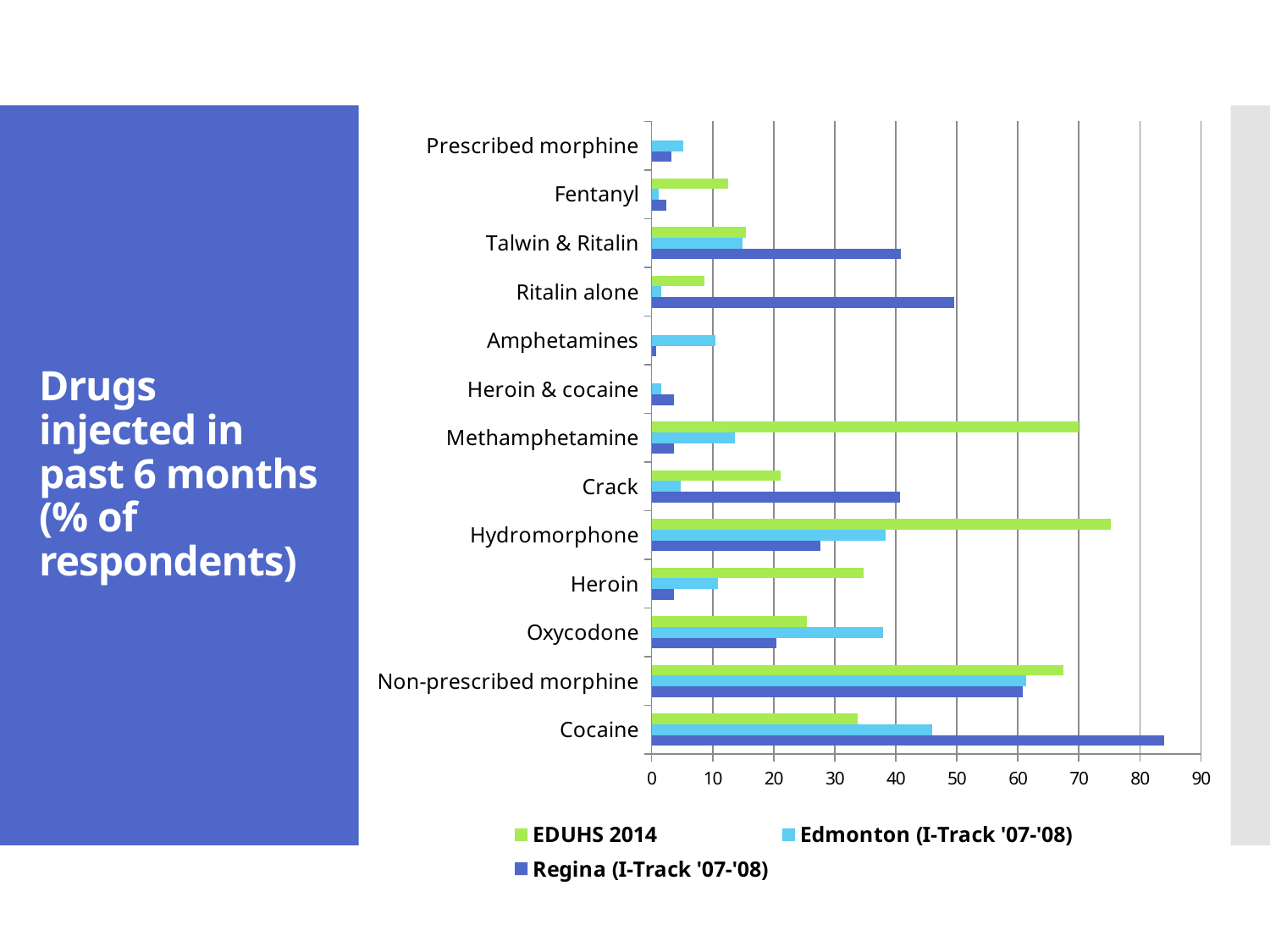
What is the title of the chart on the slide? Drugs injected in past 6 months (% of respondents) Is the Edmonton (I-Track '07-'08) value for Oxycodone greater or less than 30? greater Which drug has the highest value for the Edmonton (I-Track '07-'08) series? Non-prescribed morphine Is the Regina (I-Track '07-'08) value for Cocaine greater or less than 80? greater For Hydromorphone, which is larger: the EDUHS 2014 value or the Regina (I-Track '07-'08) value? EDUHS 2014 Which drug has the highest value for the Regina (I-Track '07-'08) series? Cocaine Is the EDUHS 2014 value for Methamphetamine greater or less than 60? greater How many series does the legend list? 3 What kind of chart is shown on the slide? bar chart Which drug has the highest value for the EDUHS 2014 series? Hydromorphone How many drug categories are listed on the chart? 13 For Cocaine, which is larger: the Regina (I-Track '07-'08) value or the Edmonton (I-Track '07-'08) value? Regina (I-Track '07-'08)